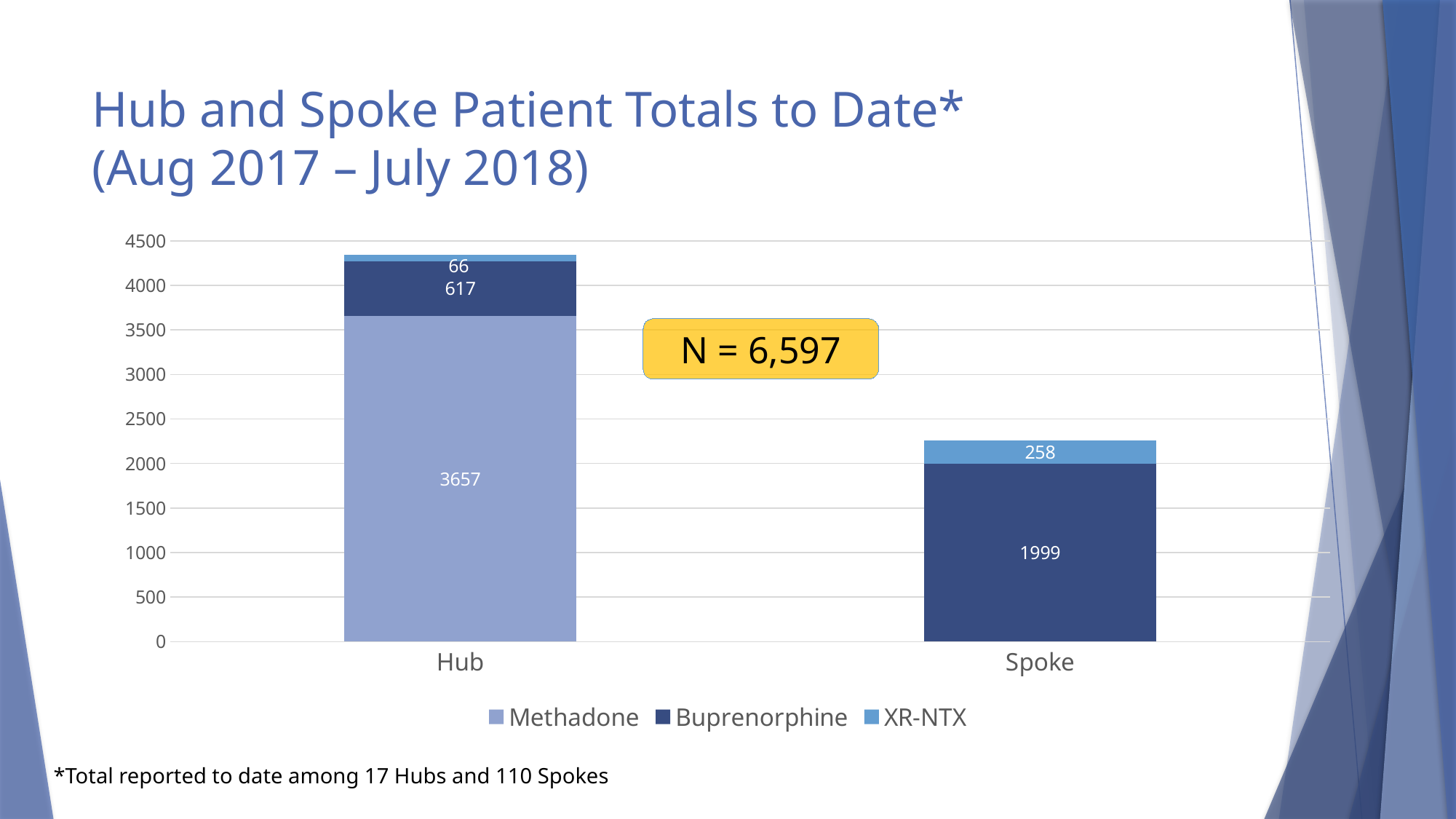
What is the XR-NTX value for Spoke? 258 What is the total of the stacked bar for Hub? 4340 What is the N value shown in the yellow box on the chart? N = 6,597 How many series does the legend list? 3 Which is larger, the XR-NTX value for Hub or for Spoke? Spoke What kind of chart is shown on the slide? Stacked bar chart What is the difference between the Buprenorphine values for Spoke and Hub? 1382 What is the Buprenorphine value for Hub? 617 What is the total of the stacked bar for Spoke? 2257 What is the Buprenorphine value for Spoke? 1999 What is the XR-NTX value for Hub? 66 What is the Methadone value for Hub? 3657